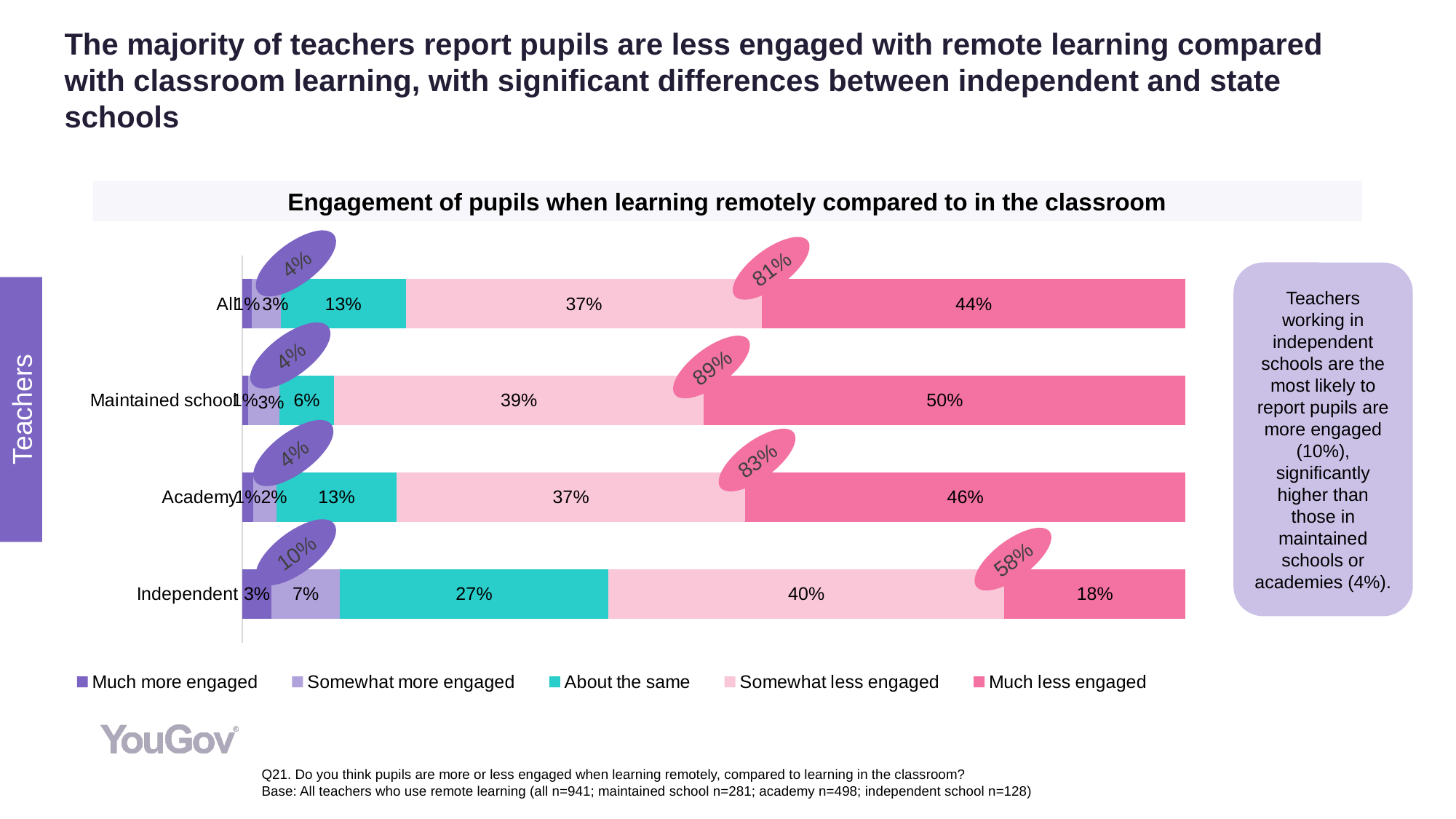
What percentage of teachers in independent schools say pupils are somewhat more engaged? 7% What percentage of teachers in maintained schools say pupils are much less engaged when learning remotely? 50% What type of chart is shown on the slide? Stacked bar chart Which has a larger 'About the same' value, Academy or Maintained school? Academy What percentage of teachers in independent schools say pupils are about the same in engagement? 27% What is the 'Somewhat less engaged' value for Academy? 37% How many series does the legend list? 5 Which category has the lowest 'Much less engaged' value? Independent Which category has the highest 'Much less engaged' value? Maintained school What is the difference between the 'Much less engaged' values for Maintained school and Independent? 32 percentage points How many categories are shown on the chart? 4 What is the title of the chart? Engagement of pupils when learning remotely compared to in the classroom